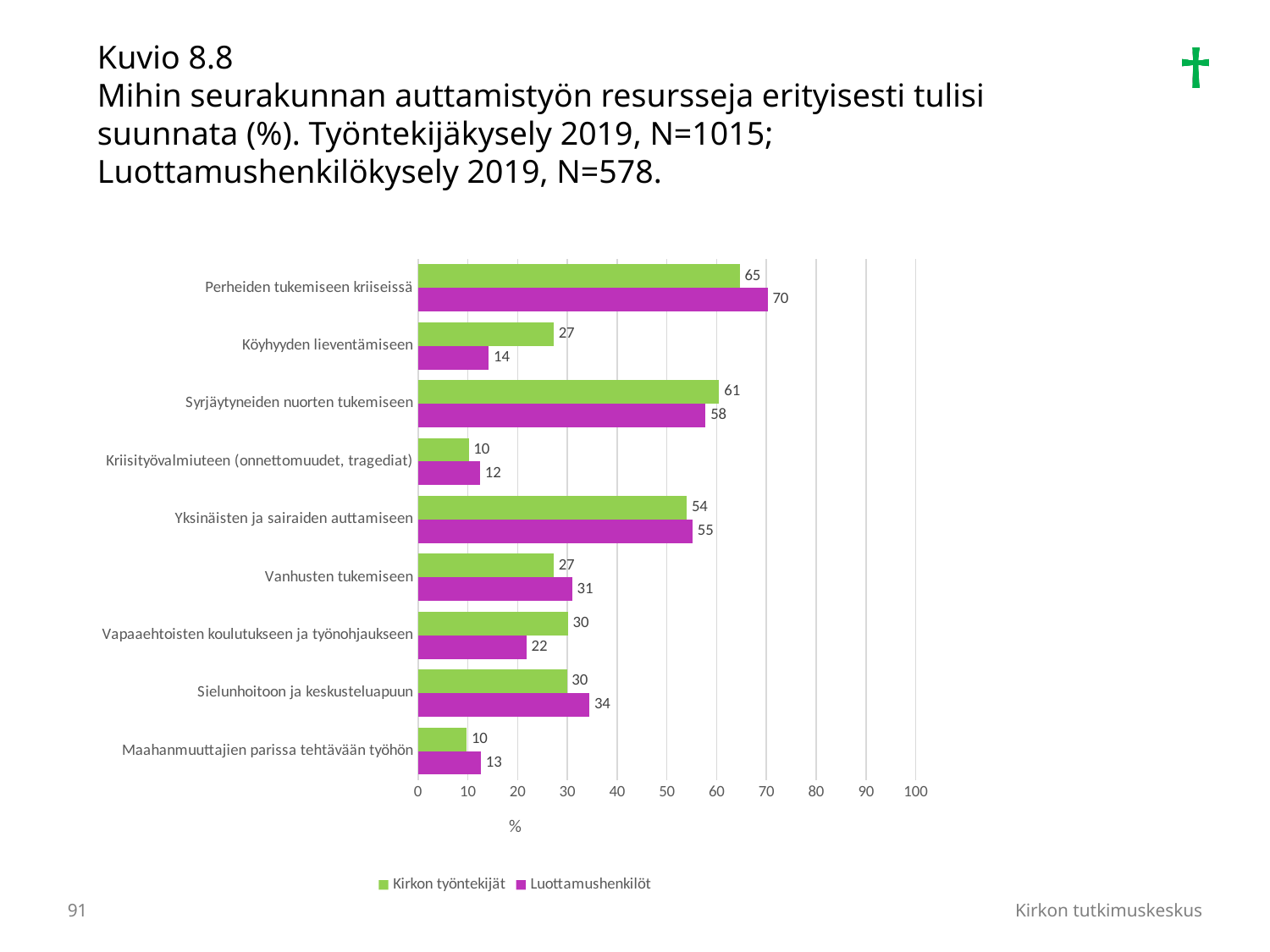
What is the value for Luottamushenkilöt for Sielunhoitoon ja keskusteluapuun? 34 What is the difference between the Kirkon työntekijät and Luottamushenkilöt values for Köyhyyden lieventämiseen? 13 How many series does the legend list? 2 Which category has the lowest value for Kirkon työntekijät? Kriisityövalmiuteen (onnettomuudet, tragediat) and Maahanmuuttajien parissa tehtävään työhön (both 10) Which is larger for Syrjäytyneiden nuorten tukemiseen: Kirkon työntekijät or Luottamushenkilöt? Kirkon työntekijät What colour are the bars for Luottamushenkilöt? Purple Is the value for Luottamushenkilöt for Yksinäisten ja sairaiden auttamiseen greater or less than 50? greater What kind of chart is shown on the slide? Bar chart How many categories are shown on the chart? 9 What is the value for Kirkon työntekijät for Perheiden tukemiseen kriiseissä? 65 Which category has the highest value for Luottamushenkilöt? Perheiden tukemiseen kriiseissä What is the value for Luottamushenkilöt for Köyhyyden lieventämiseen? 14